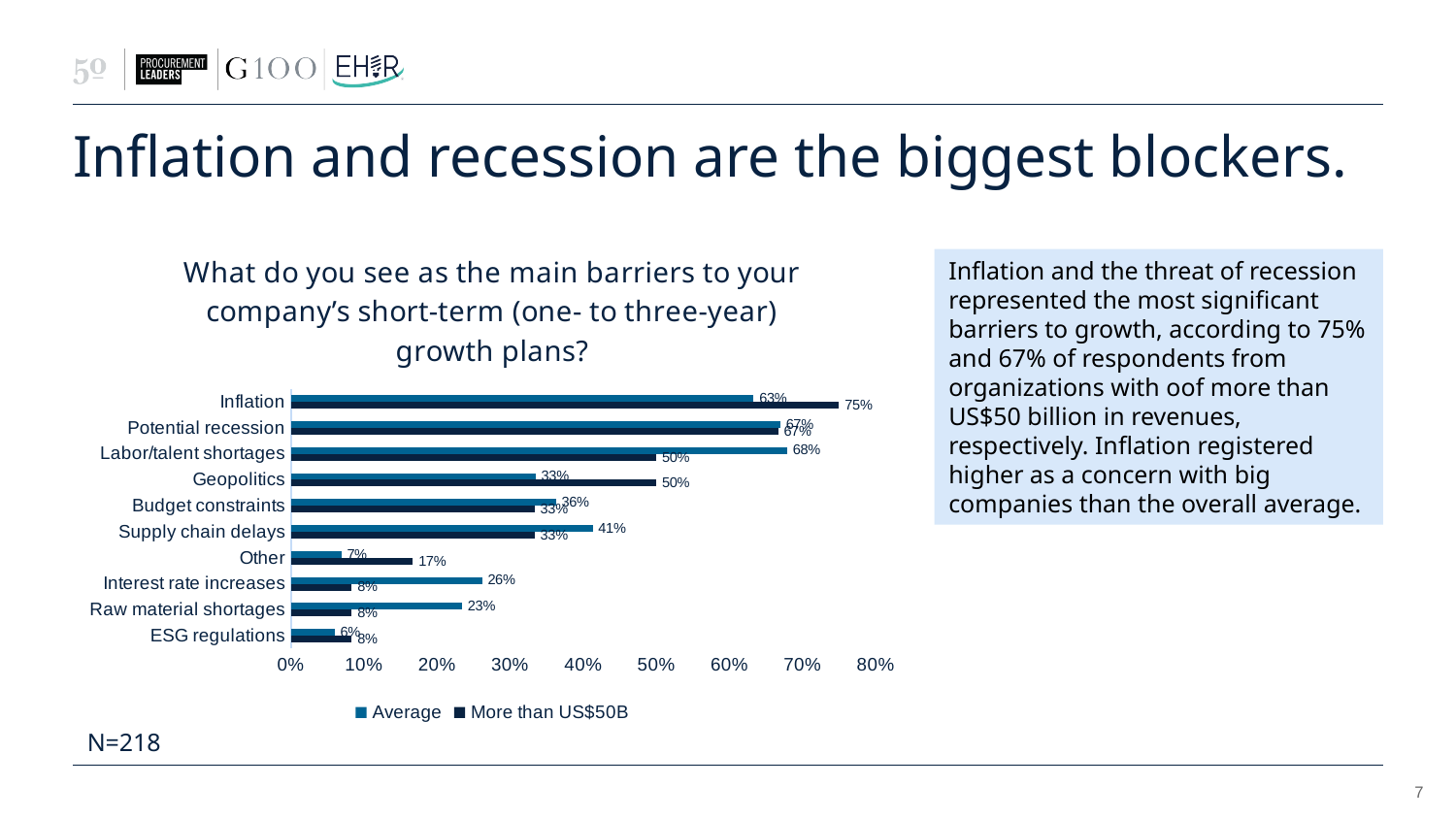
For Interest rate increases, which series has the larger value, Average or More than US$50B? Average How many barrier categories are plotted on the chart? 10 What is the difference between the More than US$50B value and the Average value for Inflation? 12% Which category has the lowest Average value? ESG regulations What sample size (N) is stated on the slide? N=218 What is the value for Inflation in the More than US$50B series? 75% What type of chart is shown on the slide? bar chart Which category has the highest value in the More than US$50B series? Inflation What is the value for Geopolitics in the More than US$50B series? 50% What is the Average value for Supply chain delays? 41% What is the Average value for Labor/talent shortages? 68% How many series does the chart legend list? 2